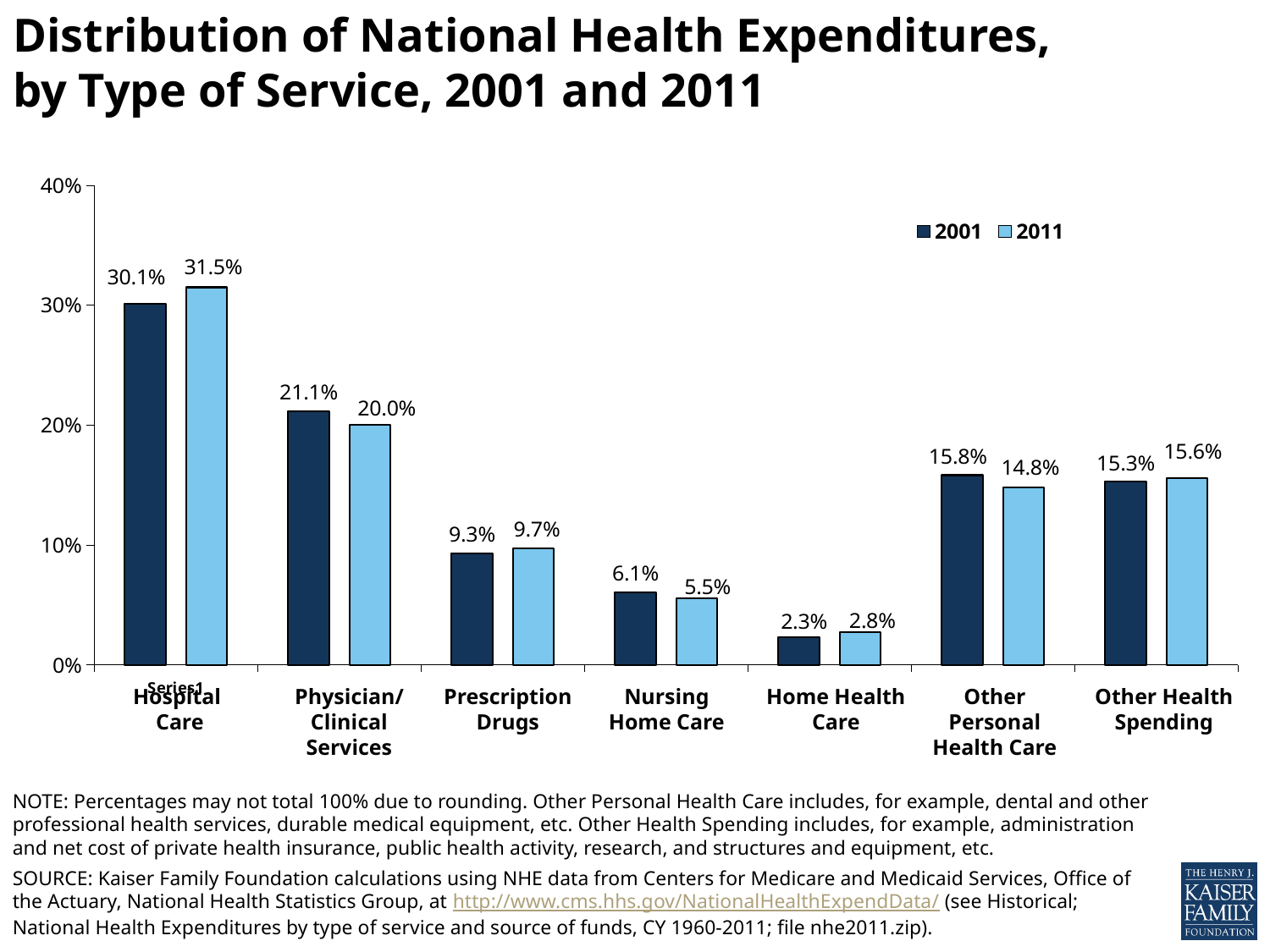
Which was larger: the Nursing Home Care share in 2001 or in 2011? 2001 What is the difference between the 2001 and 2011 shares for Physician/Clinical Services? 1.1 percentage points What was the share of national health expenditures for Hospital Care in 2011? 31.5% What was the share for Physician/Clinical Services in 2001? 21.1% Was the 2011 share for Prescription Drugs greater or less than 10%? less How many series does the legend list? 2 How many types of service are shown on the x axis? 7 What kind of chart is shown on the slide? Bar chart By how many percentage points did the Hospital Care share change from 2001 to 2011? 1.4 percentage points Which type of service had the lowest share of expenditures in 2001? Home Health Care What was the share for Home Health Care in 2011? 2.8% Which type of service had the highest share of expenditures in 2011? Hospital Care